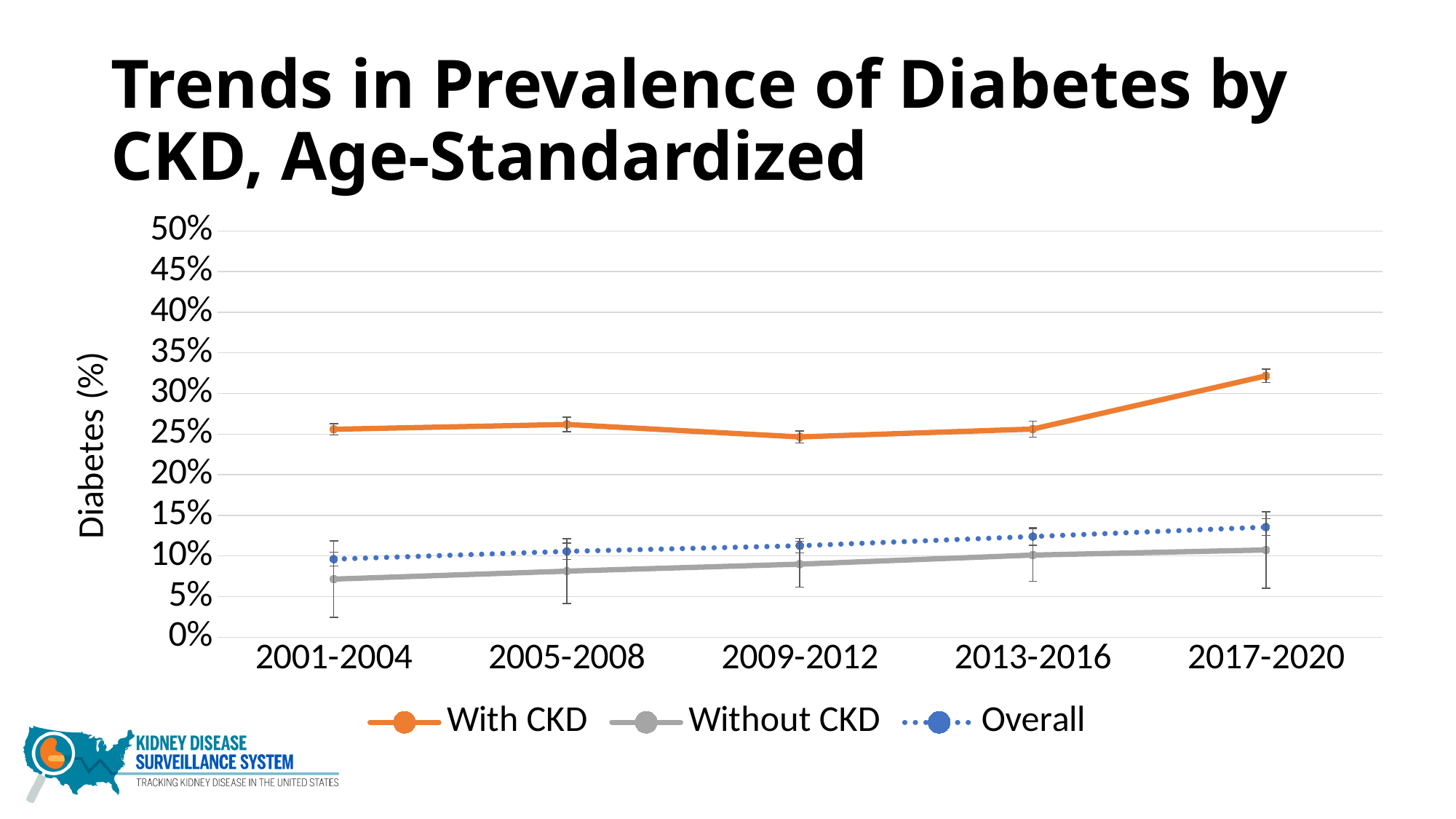
Is the With CKD value for 2017-2020 greater or less than 30%? greater Which series has the highest values across all periods? With CKD Is the Overall value for 2017-2020 greater or less than 10%? greater In 2017-2020, which is larger: the With CKD value or the Without CKD value? With CKD Is the Without CKD value for 2001-2004 greater or less than 10%? less Which series is drawn with a dotted line? Overall What type of chart is shown on the slide? line chart In which period is the With CKD series at its highest? 2017-2020 In which period is the With CKD series at its lowest? 2009-2012 How many series does the legend list? 3 Does the Without CKD series rise or fall from 2001-2004 to 2017-2020? rise How many time periods are shown on the x axis? 5